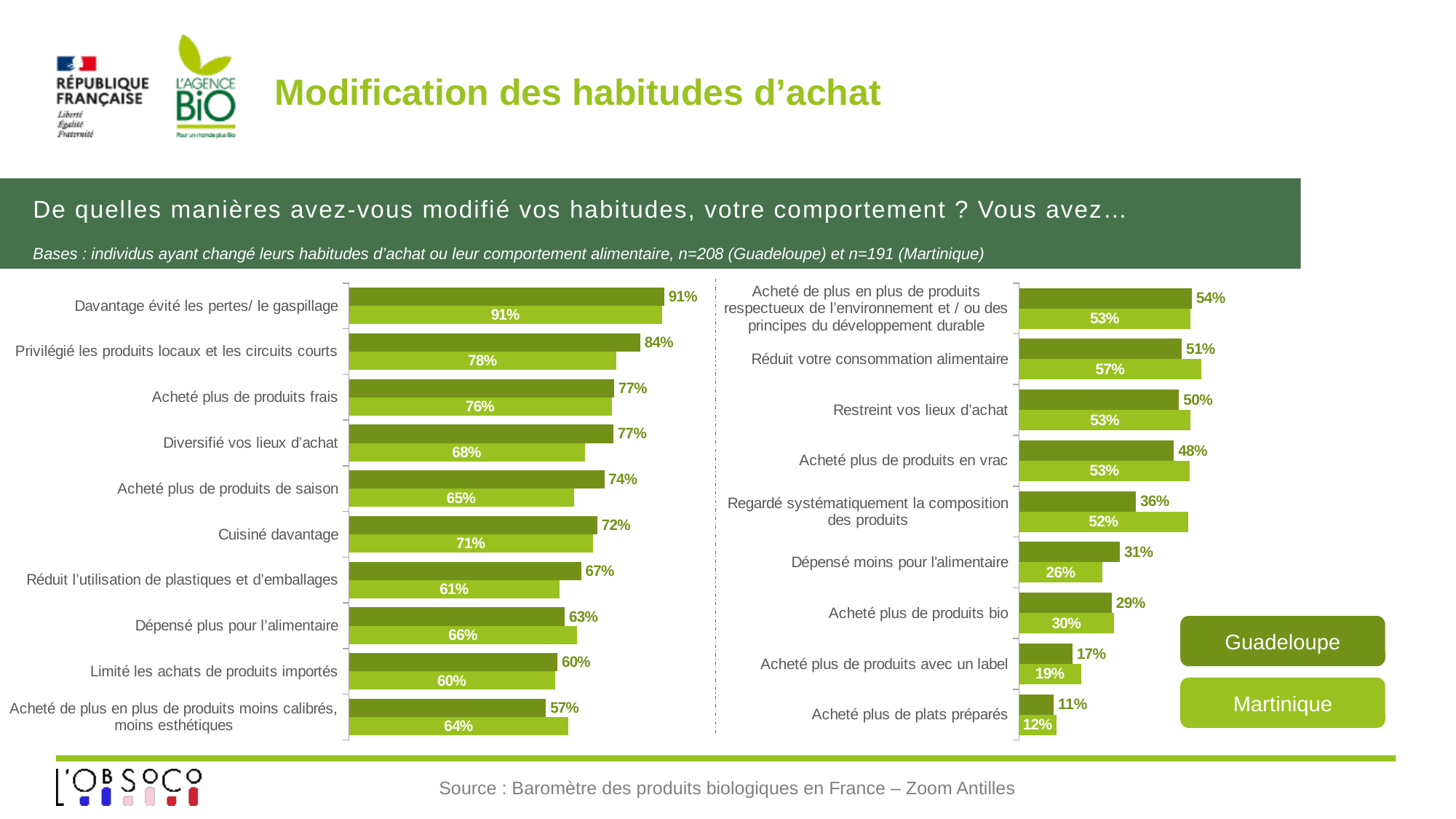
In the right chart, what is the Guadeloupe value for "Acheté plus de produits en vrac"? 48% How many categories does the left chart show? 10 In the left chart, which is larger for "Dépensé plus pour l'alimentaire": the Guadeloupe value or the Martinique value? Martinique How many categories does the right chart show? 9 How many series does the legend list? 2 In the right chart, what is the Martinique value for "Regardé systématiquement la composition des produits"? 52% In the right chart, which category has the lowest Martinique value? Acheté plus de plats préparés In the left chart, which category has the highest Guadeloupe value? Davantage évité les pertes/ le gaspillage In the right chart, what is the difference between the Martinique and Guadeloupe values for "Regardé systématiquement la composition des produits"? 16 percentage points What type of chart is used on this slide? Bar chart In the left chart, what is the Martinique value for "Diversifié vos lieux d'achat"? 68% In the left chart, what is the Guadeloupe value for "Privilégié les produits locaux et les circuits courts"? 84%